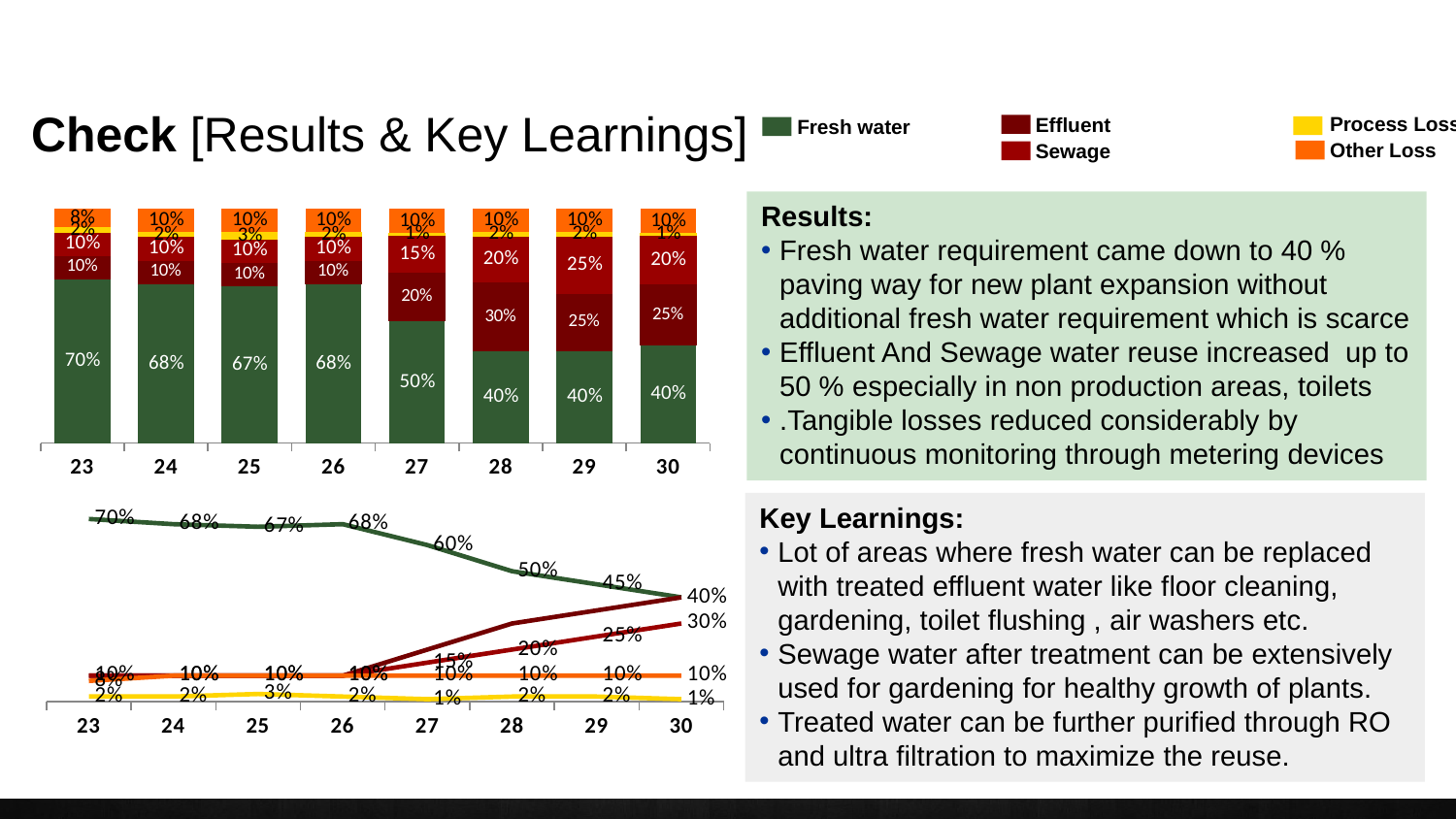
In the bottom line chart, what is the Process Loss value at 25? 3% How many series does the legend list? 5 In the bottom line chart, what is the Fresh water value at 27? 60% How many categories are shown on the x axis of the top stacked bar chart? 8 In the top stacked bar chart, what is the Fresh water value for 23? 70% In the top stacked bar chart, which has the larger Fresh water value, 24 or 25? 24 What kind of chart is the top chart on the slide? Stacked bar chart In the top stacked bar chart, which category has the highest Fresh water value? 23 In the top stacked bar chart, what is the difference between the Fresh water values for 23 and 30? 30% What kind of chart is the bottom chart on the slide? Line chart In the bottom line chart, does the Fresh water line rise or fall from 23 to 30? Falls In the top stacked bar chart, what is the Fresh water value for 30? 40%